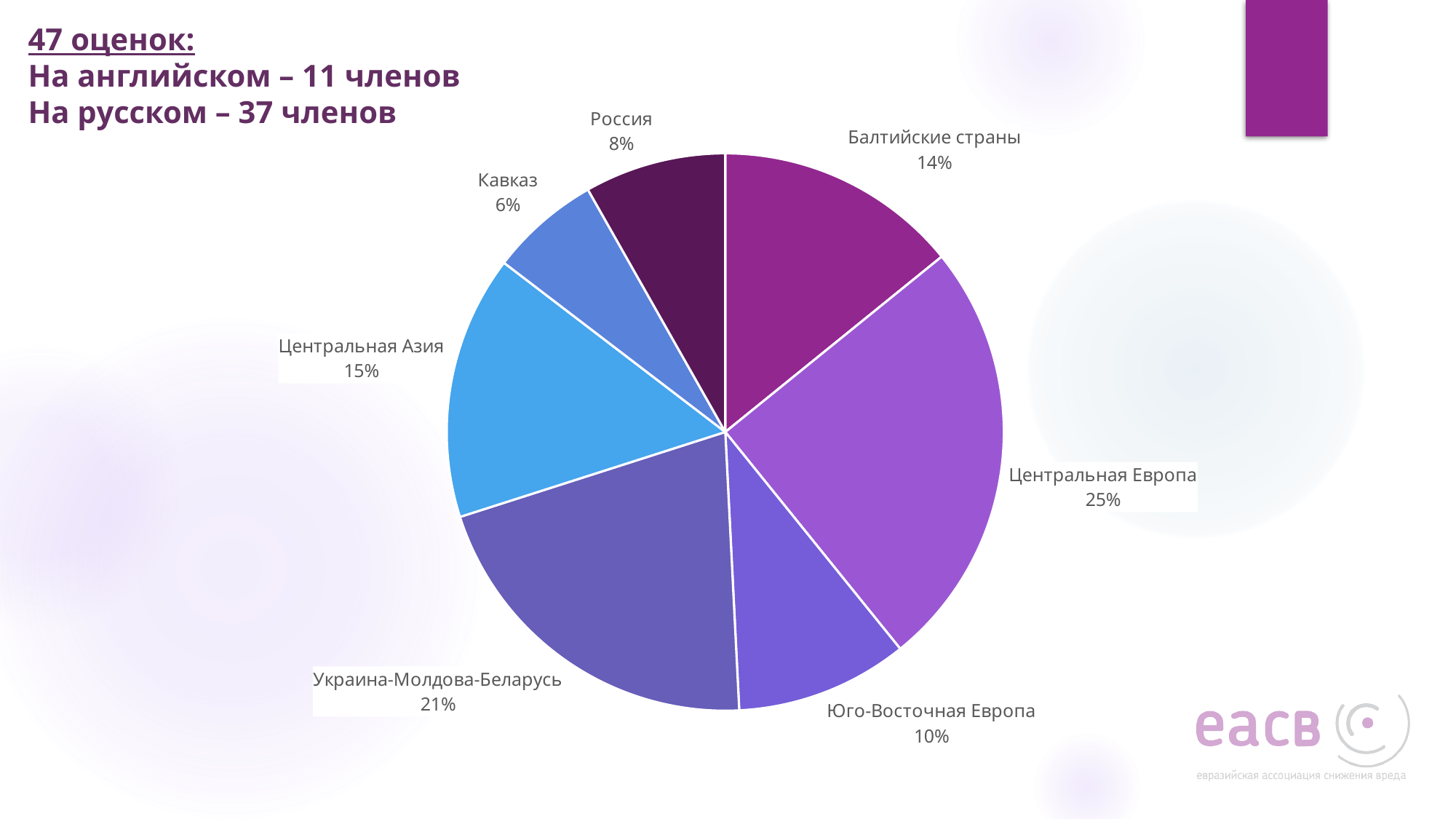
Which region has the largest slice of the pie? Центральная Европа What share of the pie does Россия have? 8% What kind of chart is shown on the slide? Pie chart According to the text on the slide, how many assessments (оценок) were there in total? 47 What share of the pie does Центральная Европа have? 25% What share of the pie does Украина-Молдова-Беларусь have? 21% Which region has the smallest slice of the pie? Кавказ What is the difference in percentage points between Центральная Европа and Юго-Восточная Европа? 15 How many slices does the pie chart have? 7 Which is larger, the share for Балтийские страны or the share for Центральная Азия? Центральная Азия What share of the pie does Кавказ have? 6% What is the combined share of Россия and Кавказ? 14%